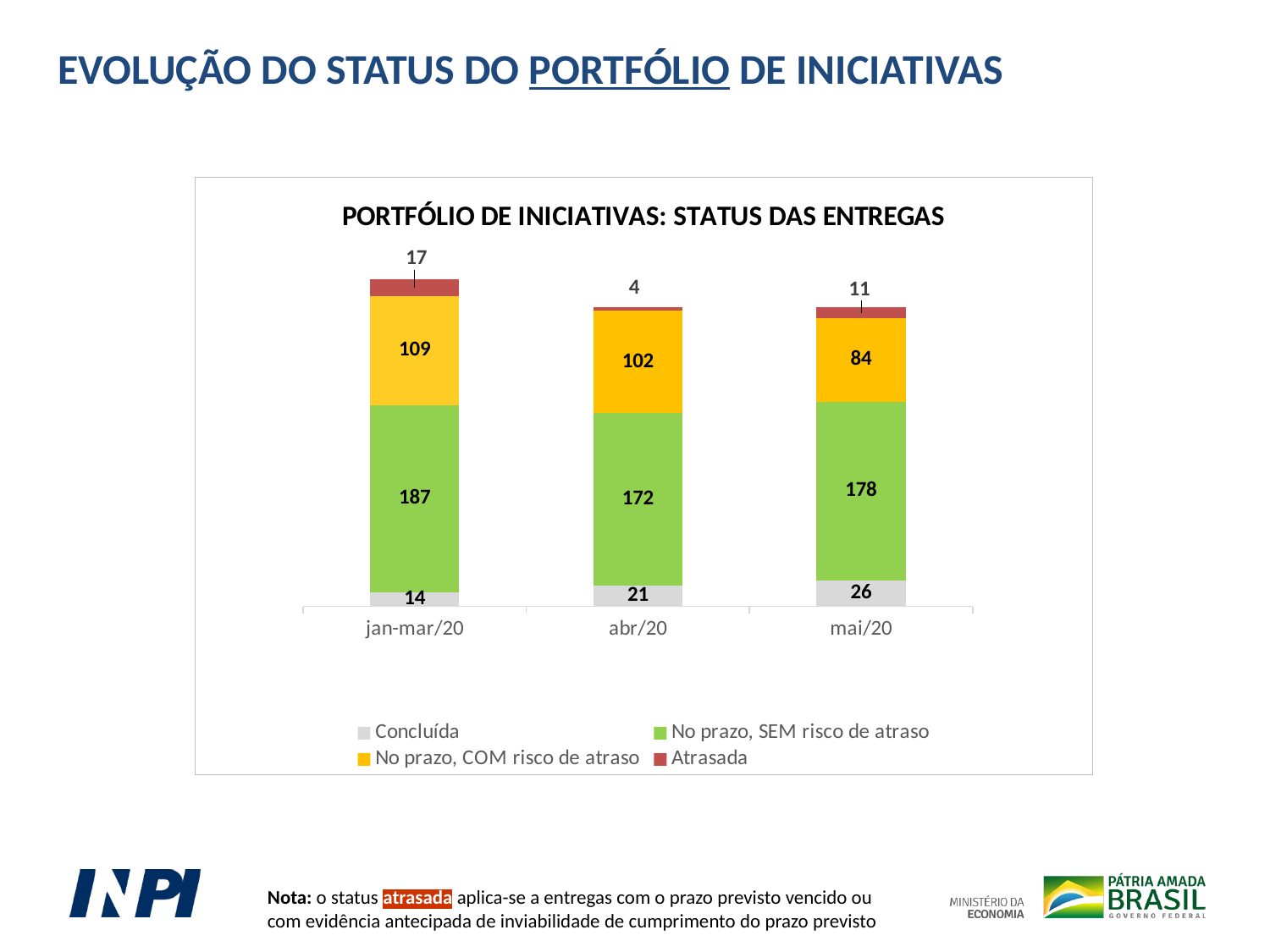
What is the value of 'No prazo, SEM risco de atraso' for jan-mar/20? 187 What is the difference between the 'No prazo, COM risco de atraso' values for jan-mar/20 and mai/20? 25 How many periods are shown on the x axis? 3 Which is larger: 'Concluída' for abr/20 or 'Concluída' for jan-mar/20? abr/20 Which period has the lowest value for 'No prazo, COM risco de atraso'? mai/20 What is the value of 'Concluída' for mai/20? 26 How many series does the legend list? 4 Which period has the highest value for 'Atrasada'? jan-mar/20 What type of chart is shown on the slide? Stacked bar chart Does the 'Concluída' value rise or fall from jan-mar/20 to mai/20? Rise What is the total of the stacked bar for jan-mar/20? 327 What is the value of 'Atrasada' for abr/20? 4